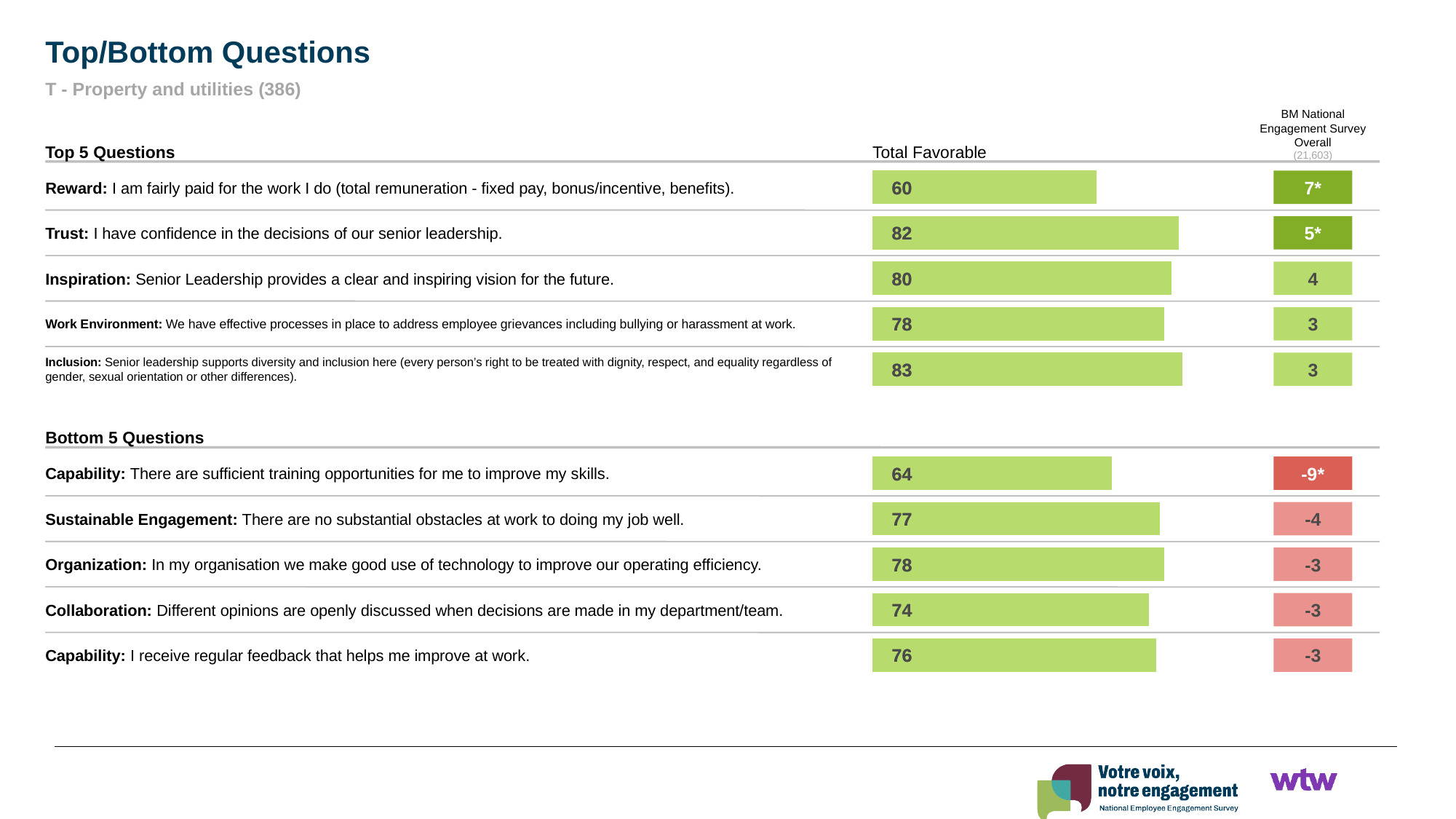
In the Top 5 Questions chart, which item has the lowest Total Favorable value? Reward In the Top 5 Questions chart, what is the Total Favorable value for the Trust item? 82 In the Top 5 Questions chart, which item has the highest Total Favorable value? Inclusion In the Top 5 Questions chart, what is the BM National Engagement Survey Overall difference shown for the Reward item? 7* In the Bottom 5 Questions chart, which item has the highest Total Favorable value? Organization In the Bottom 5 Questions chart, what is the BM National Engagement Survey Overall difference shown for the Capability training opportunities item? -9* In the Bottom 5 Questions chart, which has a larger Total Favorable value: Sustainable Engagement or Collaboration? Sustainable Engagement How many items are shown in the Bottom 5 Questions chart? 5 What kind of chart is used to show the Total Favorable values on this slide? Bar chart In the Top 5 Questions chart, what is the difference in Total Favorable between the Inclusion item and the Reward item? 23 In the Bottom 5 Questions chart, which item has the lowest Total Favorable value? Capability: There are sufficient training opportunities for me to improve my skills. In the Bottom 5 Questions chart, what is the Total Favorable value for the Collaboration item? 74